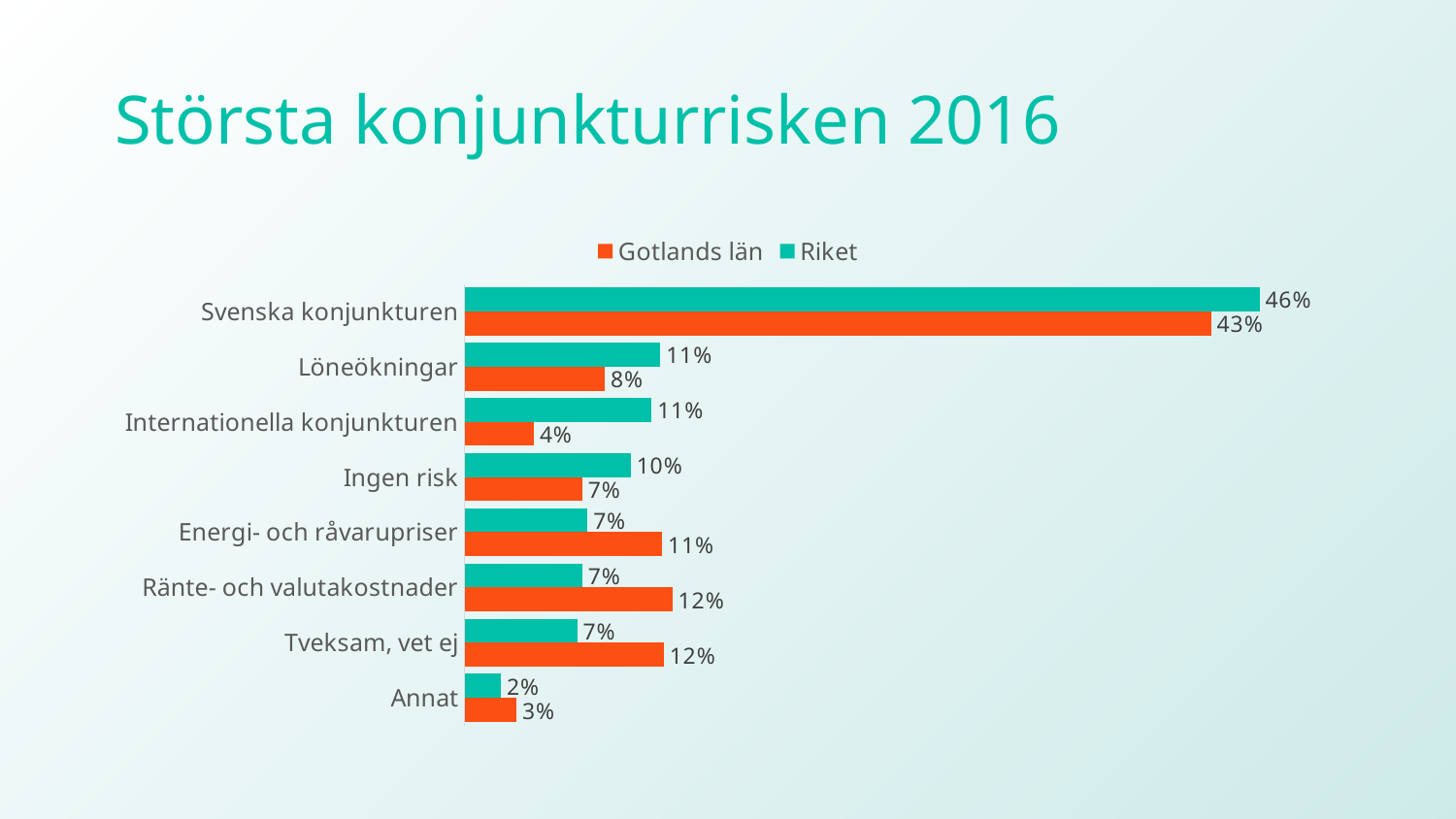
What is the value for Riket for Svenska konjunkturen? 46% What is the difference between Riket and Gotlands län for Internationella konjunkturen? 7% Which category has the lowest value for Riket? Annat What is the value for Gotlands län for Ränte- och valutakostnader? 12% Which is larger for Löneökningar, Gotlands län or Riket? Riket Which category has the highest value for Gotlands län? Svenska konjunkturen What kind of chart is shown on the slide? Bar chart How many series does the legend list? 2 What is the difference between Riket and Gotlands län for Svenska konjunkturen? 3% How many categories are shown in the chart? 8 Which is larger for Energi- och råvarupriser, Gotlands län or Riket? Gotlands län What is the value for Gotlands län for Internationella konjunkturen? 4%